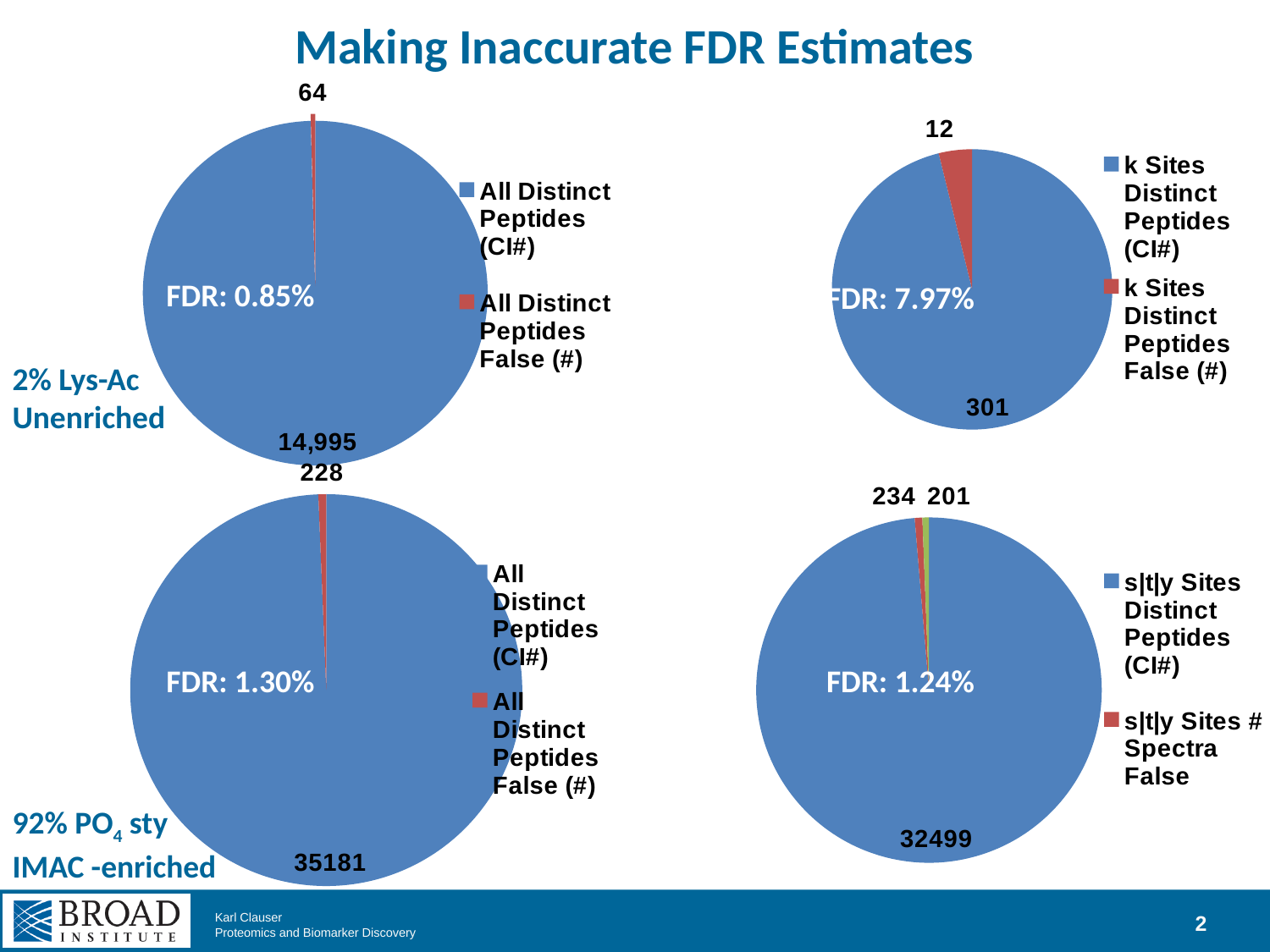
In the top-left pie chart (2% Lys-Ac Unenriched), what is the value for All Distinct Peptides (CI#)? 14,995 In the bottom-right pie chart (s|t|y Sites), what is the value for s|t|y Sites Distinct Peptides (CI#)? 32499 In the bottom-left pie chart (92% PO4 sty IMAC-enriched), what is the difference between the 35181 slice and the 228 slice? 34953 What kind of chart is used for the top-left chart on the slide? Pie chart How many entries does the legend of the bottom-right pie chart (s|t|y Sites) list? 2 In the top-left pie chart (2% Lys-Ac Unenriched), which slice is larger: All Distinct Peptides (CI#) or All Distinct Peptides False (#)? All Distinct Peptides (CI#) In the top-right pie chart (k Sites), what is the value for k Sites Distinct Peptides (CI#)? 301 In the top-right pie chart (k Sites), what is the value for k Sites Distinct Peptides False (#)? 12 In the top-right pie chart (k Sites), what is the total of the two slices (301 and 12)? 313 In the bottom-left pie chart (92% PO4 sty IMAC-enriched), what is the value for All Distinct Peptides (CI#)? 35181 What FDR value is printed on the top-right pie chart (k Sites)? FDR: 7.97% In the top-left pie chart (2% Lys-Ac Unenriched), what is the value for All Distinct Peptides False (#)? 64